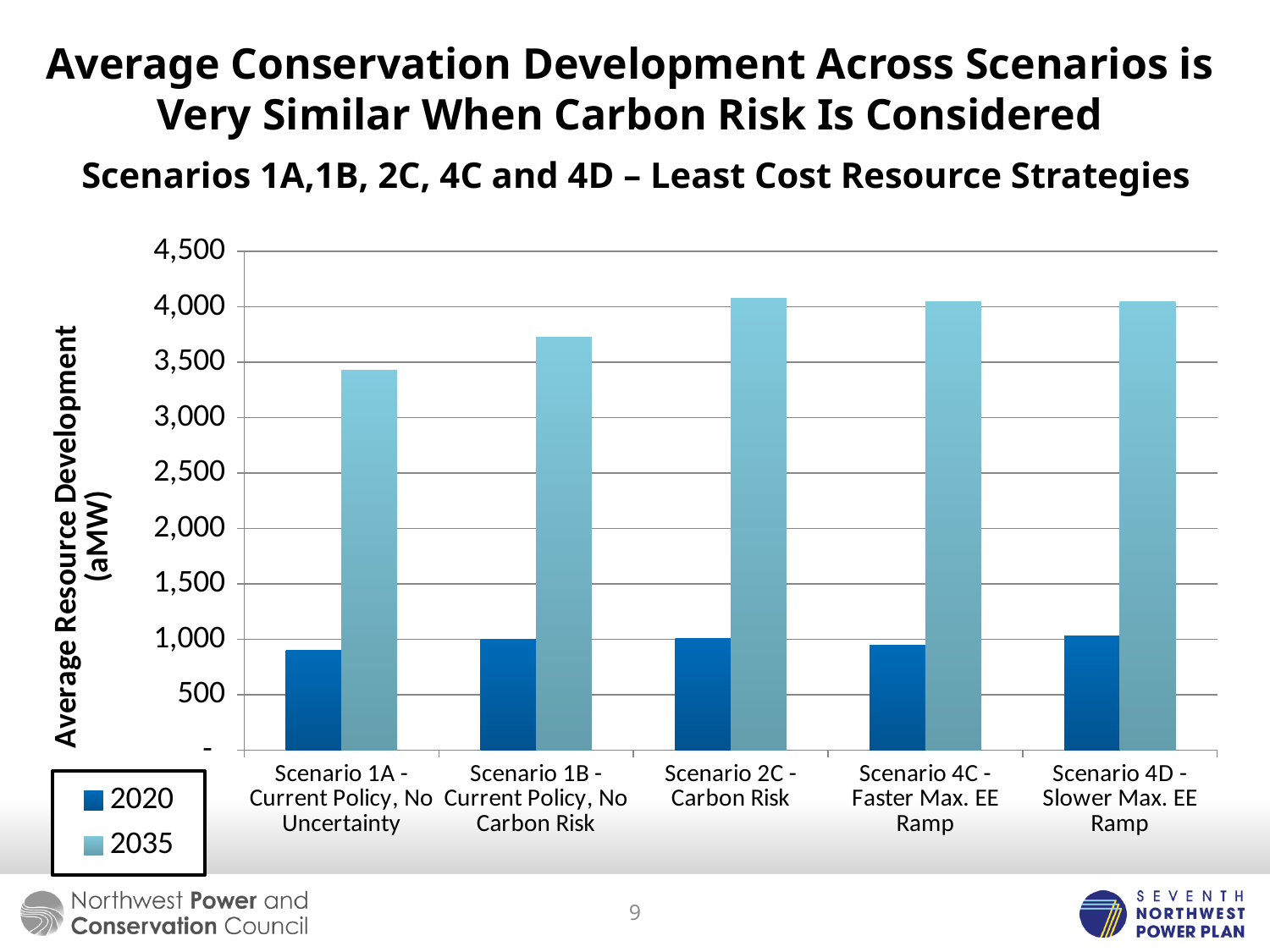
What is the title of the chart's vertical axis? Average Resource Development (aMW) Is the 2035 value for Scenario 1B - Current Policy, No Carbon Risk greater or less than 3,500? greater Which scenario has the lowest 2020 value? Scenario 1A - Current Policy, No Uncertainty How many series does the chart's legend list? 2 Is the 2035 value for Scenario 1A - Current Policy, No Uncertainty greater or less than 3,500? less Which is larger, the 2035 value for Scenario 1B - Current Policy, No Carbon Risk or the 2035 value for Scenario 1A - Current Policy, No Uncertainty? Scenario 1B - Current Policy, No Carbon Risk Which is larger, the 2020 value for Scenario 1B - Current Policy, No Carbon Risk or the 2020 value for Scenario 1A - Current Policy, No Uncertainty? Scenario 1B - Current Policy, No Carbon Risk What kind of chart is shown on the slide? bar chart Is the 2020 value for Scenario 4C - Faster Max. EE Ramp greater or less than 1,000? less Which scenario has the lowest 2035 value? Scenario 1A - Current Policy, No Uncertainty How many scenarios are shown on the x axis of the chart? 5